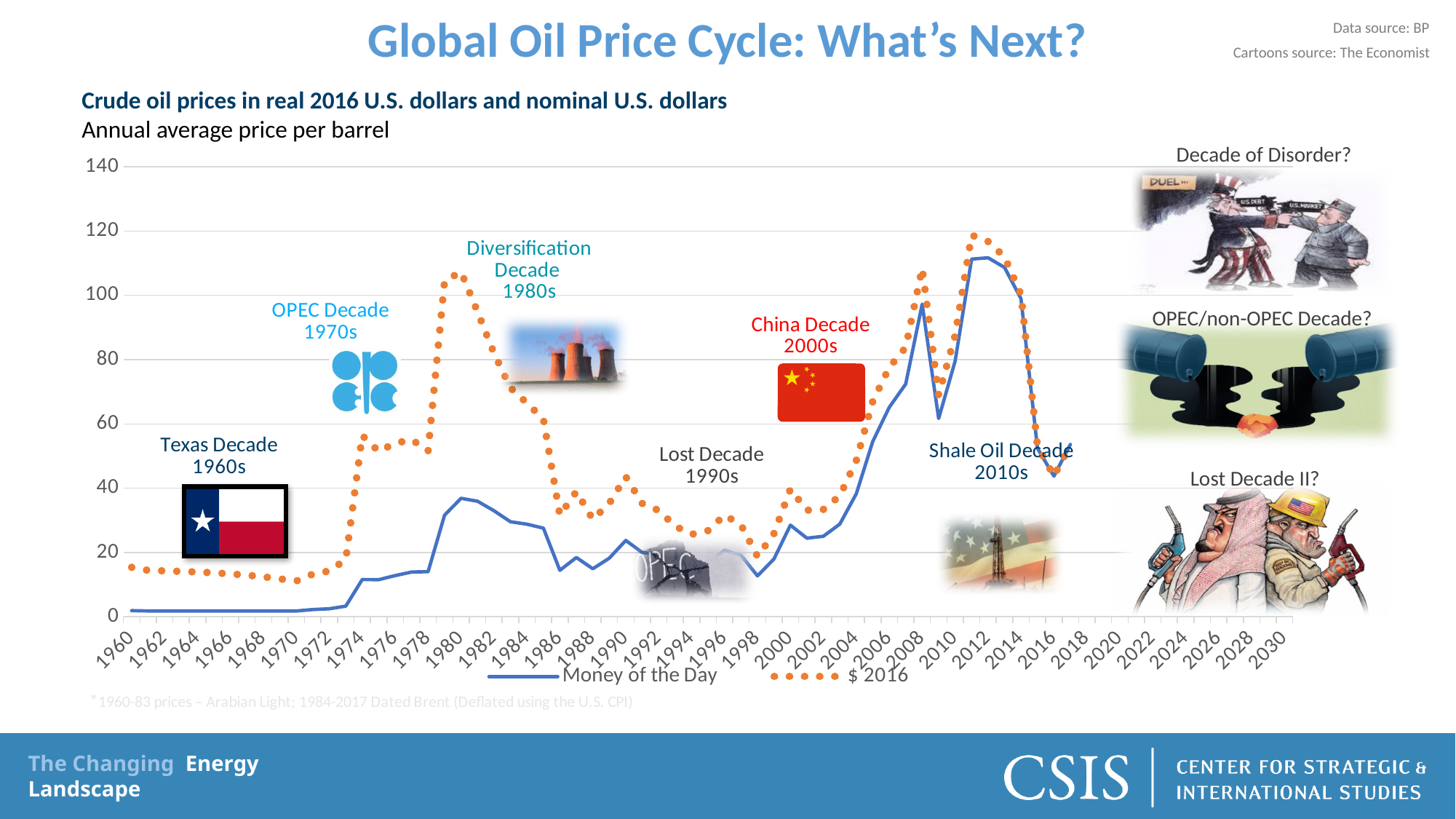
Does the Money of the Day series rise or fall between 2012 and 2016? Fall What are the two series named in the legend? Money of the Day and $ 2016 Is the $ 2016 value for 1960 greater or less than 20? less Is the Money of the Day value for 1980 greater or less than 40? less Is the Money of the Day value for 2012 greater or less than 100? greater In 1980, which series has the higher value, Money of the Day or $ 2016? $ 2016 What kind of chart is shown on the slide? Line chart What is the title of the chart? Crude oil prices in real 2016 U.S. dollars and nominal U.S. dollars How many series does the chart's legend list? 2 Does the $ 2016 series rise or fall between 1970 and 1980? Rise